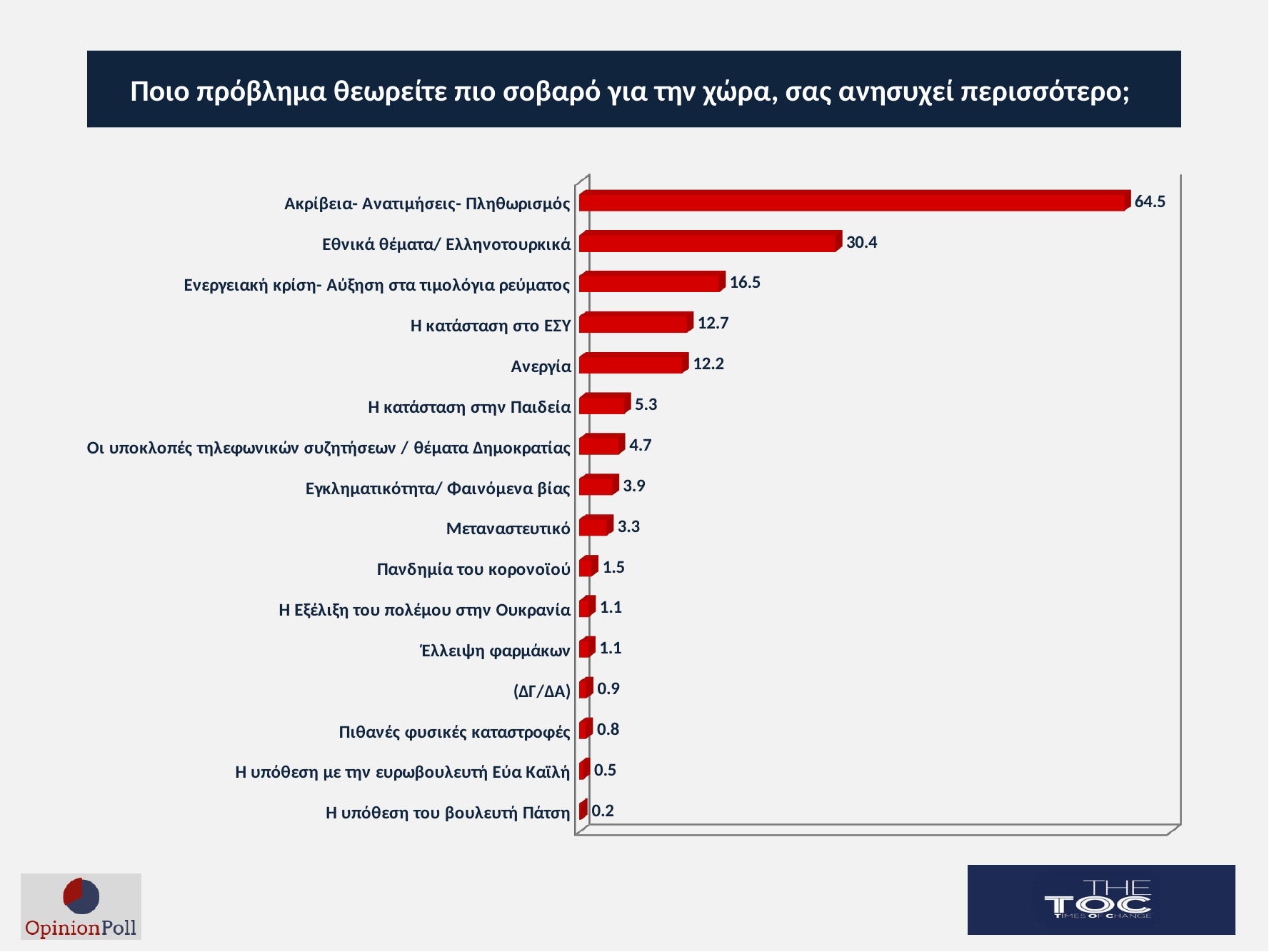
What colour are the bars in the chart? Red What kind of chart is shown on the slide? Bar chart Which has a larger value, "Ενεργειακή κρίση- Αύξηση στα τιμολόγια ρεύματος" or "Η κατάσταση στην Παιδεία"? Ενεργειακή κρίση- Αύξηση στα τιμολόγια ρεύματος What is the difference between the values for "Ακρίβεια- Ανατιμήσεις- Πληθωρισμός" and "Εθνικά θέματα/ Ελληνοτουρκικά"? 34.1 Which category has the lowest value? Η υπόθεση του βουλευτή Πάτση Which category has the highest value? Ακρίβεια- Ανατιμήσεις- Πληθωρισμός What value is shown for "Ανεργία"? 12.2 What value is shown for "Μεταναστευτικό"? 3.3 How many categories are shown in the chart? 16 What value is shown for "Ακρίβεια- Ανατιμήσεις- Πληθωρισμός"? 64.5 What is the difference between the values for "Η κατάσταση στο ΕΣΥ" and "Ανεργία"? 0.5 What value is shown for "Εθνικά θέματα/ Ελληνοτουρκικά"? 30.4